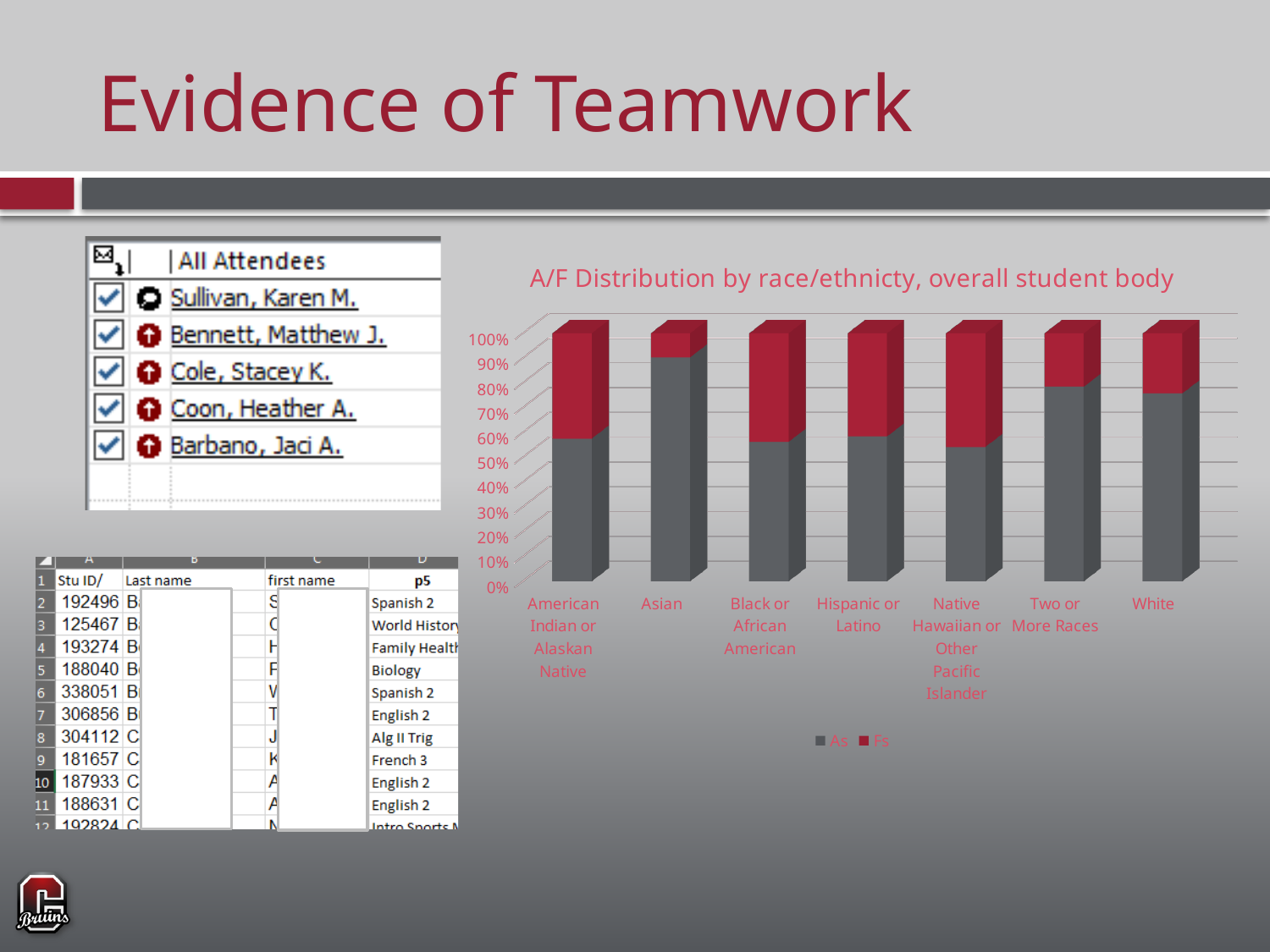
How many series does the chart's legend list? 2 Which category has the highest share of As in the chart? Asian How many race/ethnicity categories are shown on the x axis of the chart? 7 What is the title of the chart on the slide? A/F Distribution by race/ethnicty, overall student body Is the share of As for Two or More Races greater or less than 70%? greater What are the two series named in the chart's legend? As and Fs Is the share of As for Asian greater or less than 80%? greater Which category has the smallest share of Fs in the chart? Asian Which has a larger share of As, Two or More Races or Black or African American? Two or More Races Is the share of As for American Indian or Alaskan Native greater or less than 70%? less What kind of chart is shown on the slide? Stacked bar chart Which has a larger share of As, Asian or White? Asian